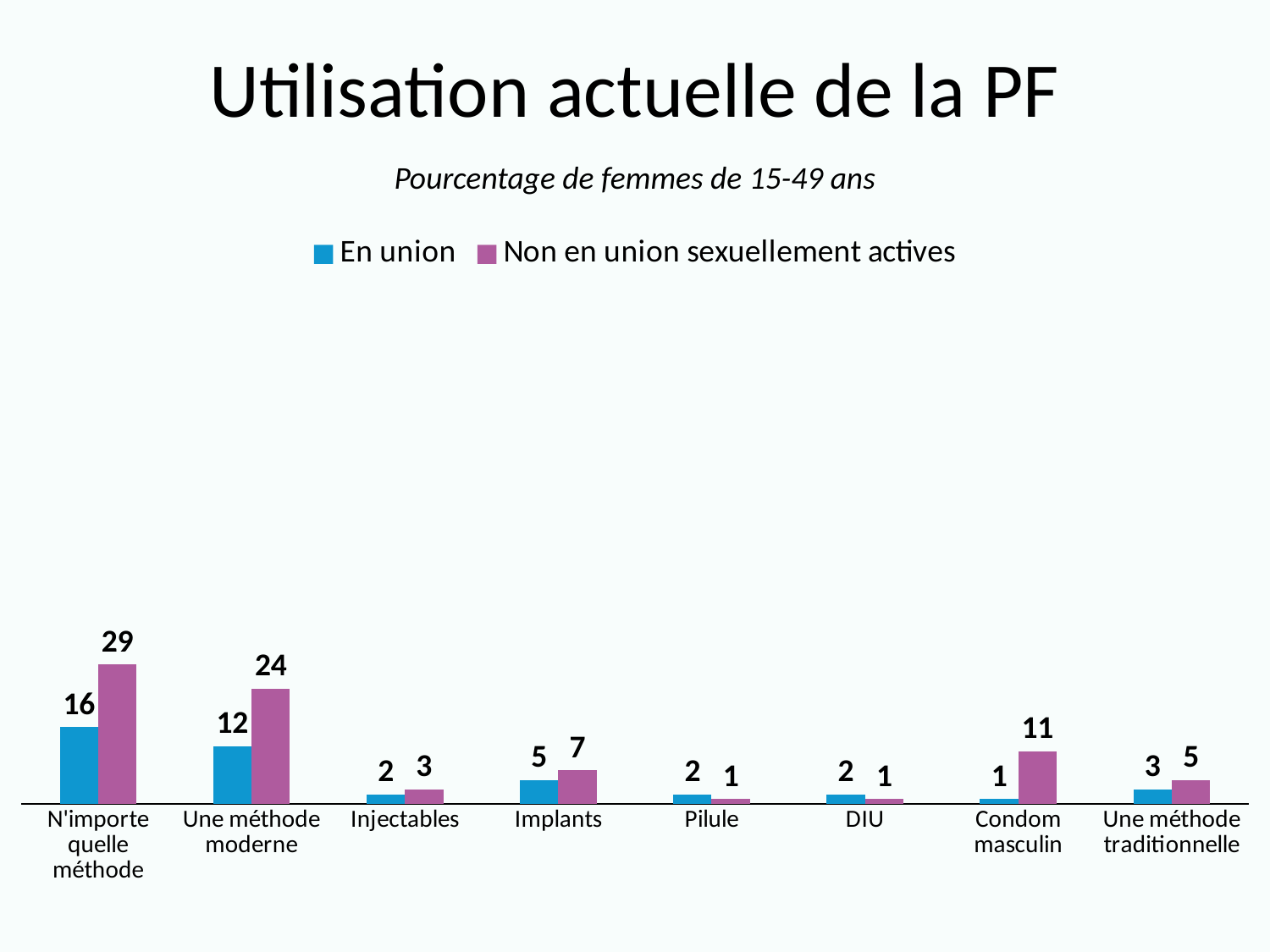
What kind of chart is shown on the slide? Bar chart What is the value for 'Non en union sexuellement actives' for Condom masculin? 11 Which is larger for Pilule: the 'En union' value or the 'Non en union sexuellement actives' value? En union What is the value for 'En union' for Une méthode moderne? 12 What is the value for 'En union' for Implants? 5 How many series does the legend list? 2 Which category has the highest value for 'Non en union sexuellement actives'? N'importe quelle méthode What is the difference between the 'Non en union sexuellement actives' and 'En union' values for N'importe quelle méthode? 13 How many categories are shown on the x axis? 8 What is the title of the chart? Utilisation actuelle de la PF Which category has the lowest value for 'En union'? Condom masculin What is the difference between the 'Non en union sexuellement actives' and 'En union' values for Une méthode moderne? 12